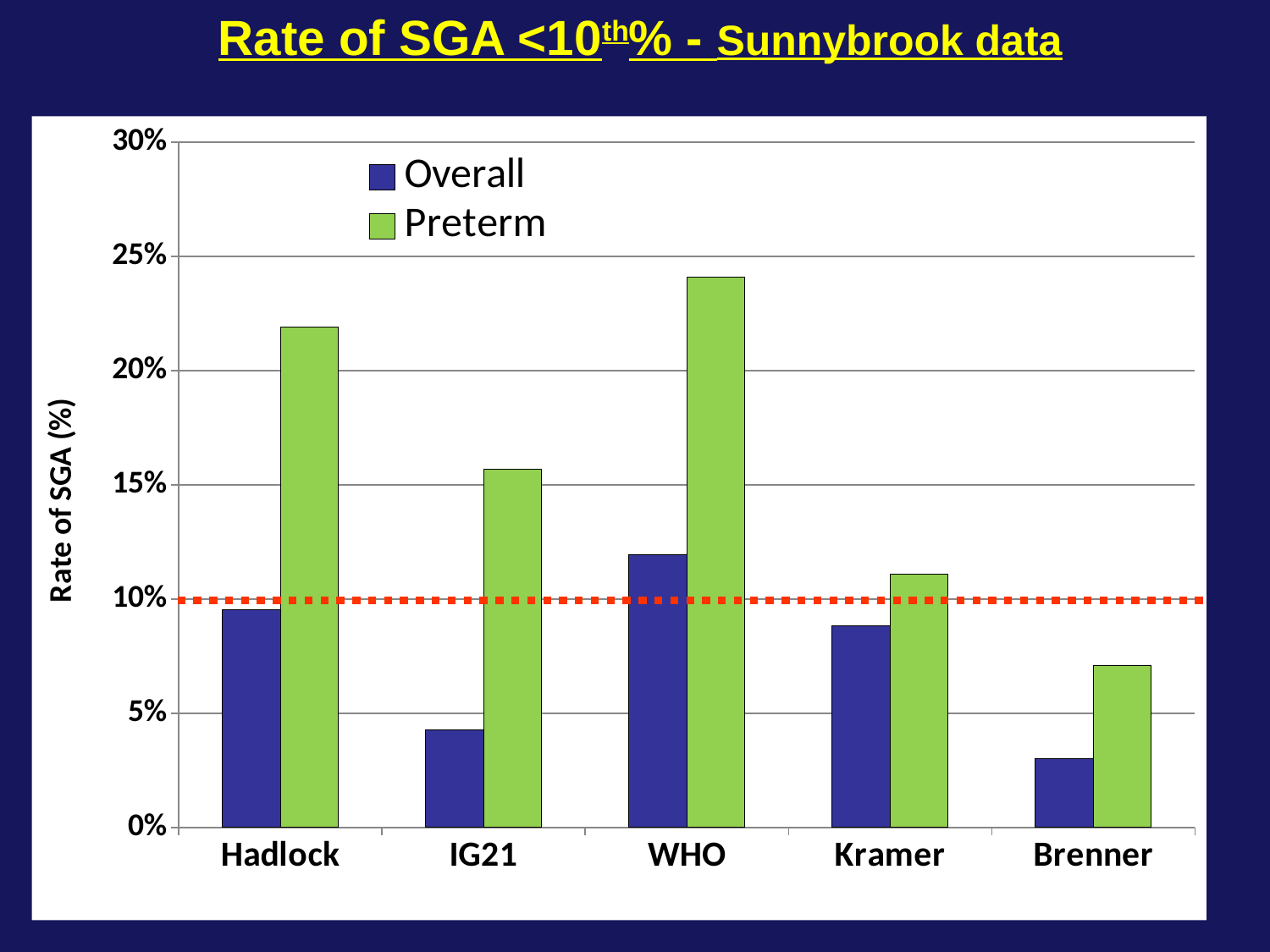
Is the Preterm value for IG21 greater or less than 15%? greater Which category has the highest Preterm value? WHO Which category has the lowest Preterm value? Brenner Which category has the lowest Overall value? Brenner Which is larger for Hadlock, the Overall value or the Preterm value? Preterm Which category has the highest Overall value? WHO What is the label of the y axis? Rate of SGA (%) Is the Preterm value for Brenner greater or less than 10%? less Is the Overall value for WHO greater or less than 10%? greater How many categories are shown on the x axis? 5 What kind of chart is shown on the slide? bar chart How many series does the legend list? 2